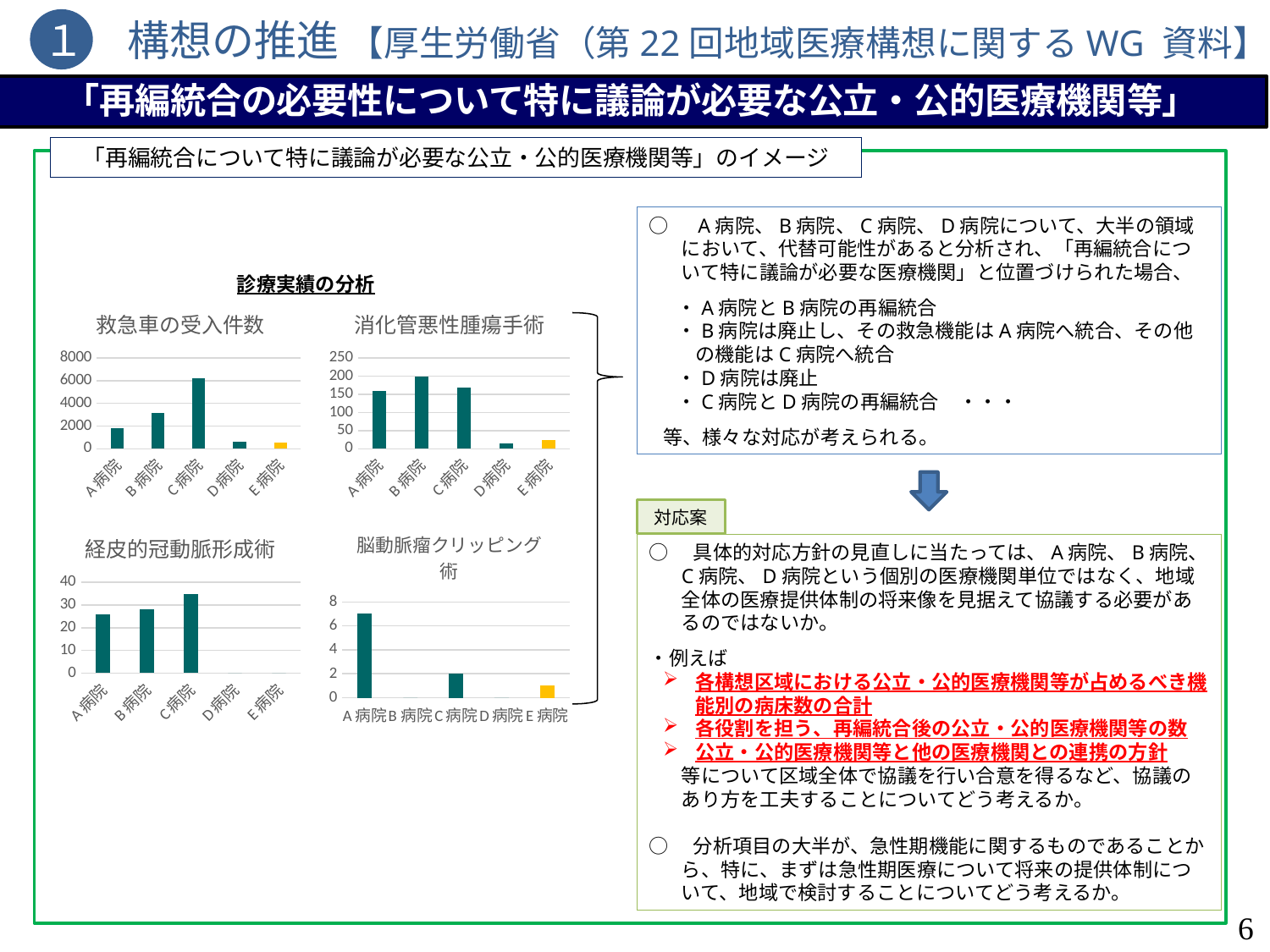
How many bar charts are shown under the heading 診療実績の分析? 4 In the 消化管悪性腫瘍手術 chart, which is larger, the value for A病院 or D病院? A病院 In the 救急車の受入件数 chart, is the value for C病院 greater or less than 4000? greater In the 消化管悪性腫瘍手術 chart, which hospital has the highest value? B病院 How many hospitals are shown on the x axis of the 経皮的冠動脈形成術 chart? 5 In the 消化管悪性腫瘍手術 chart, is the value for B病院 greater or less than 150? greater What kind of chart is the 救急車の受入件数 chart? bar chart In the 経皮的冠動脈形成術 chart, is the value for C病院 greater or less than 30? greater In the 経皮的冠動脈形成術 chart, which hospital has the highest value? C病院 In the 脳動脈瘤クリッピング術 chart, which hospital has the highest value? A病院